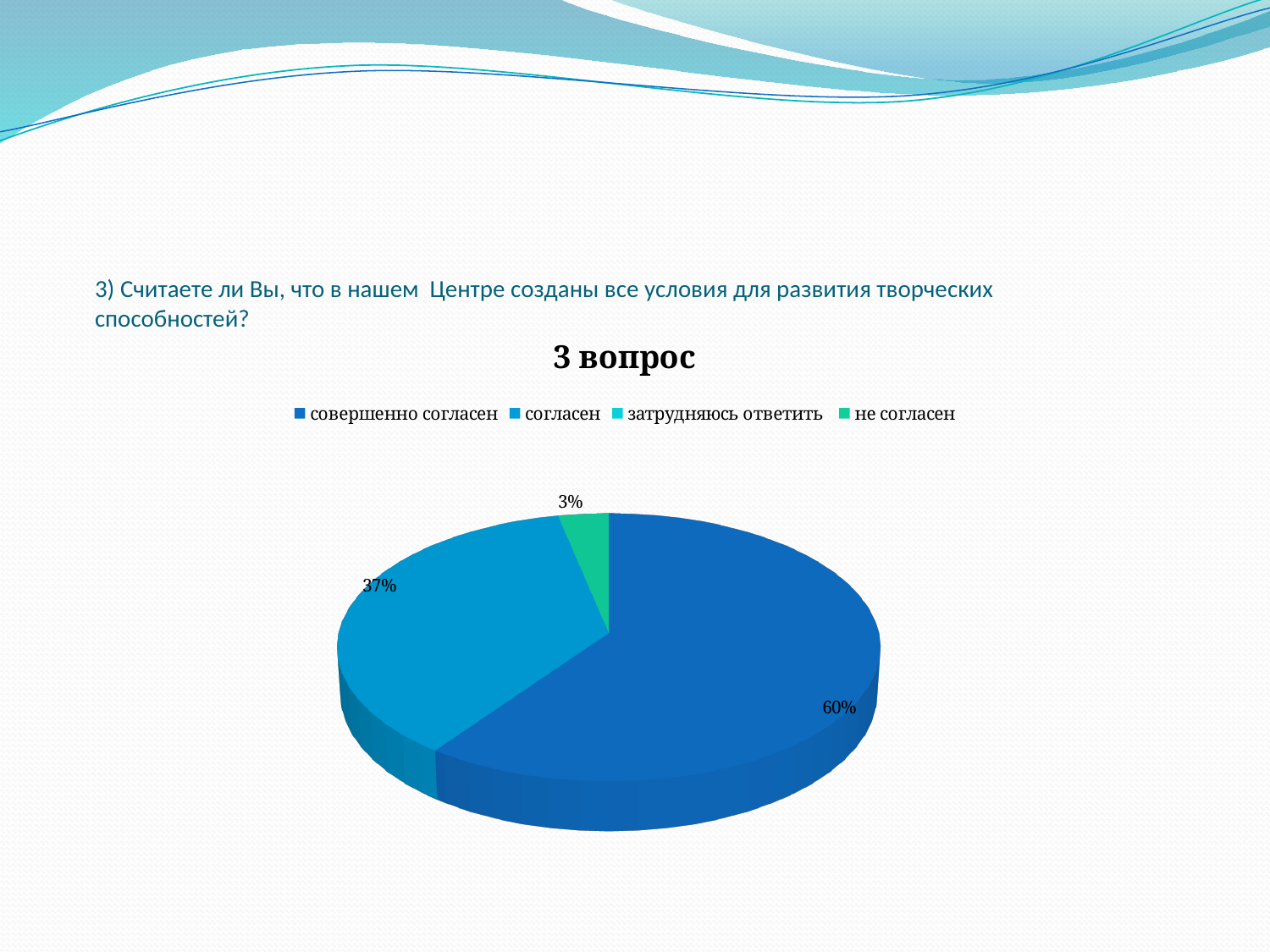
Which legend entry is listed first? совершенно согласен How many entries does the chart legend list? 4 What is the value of the smallest labelled slice in the pie? 3% Which category has the largest slice of the pie? совершенно согласен What is the title of the chart? 3 вопрос What share of the pie does "совершенно согласен" have? 60% What is the difference between the shares for "совершенно согласен" and "согласен"? 23% Which is larger, the share for "совершенно согласен" or the share for "согласен"? совершенно согласен What share of the pie does "согласен" have? 37% What kind of chart is shown on the slide? pie chart How many slices with data labels are visible in the pie? 3